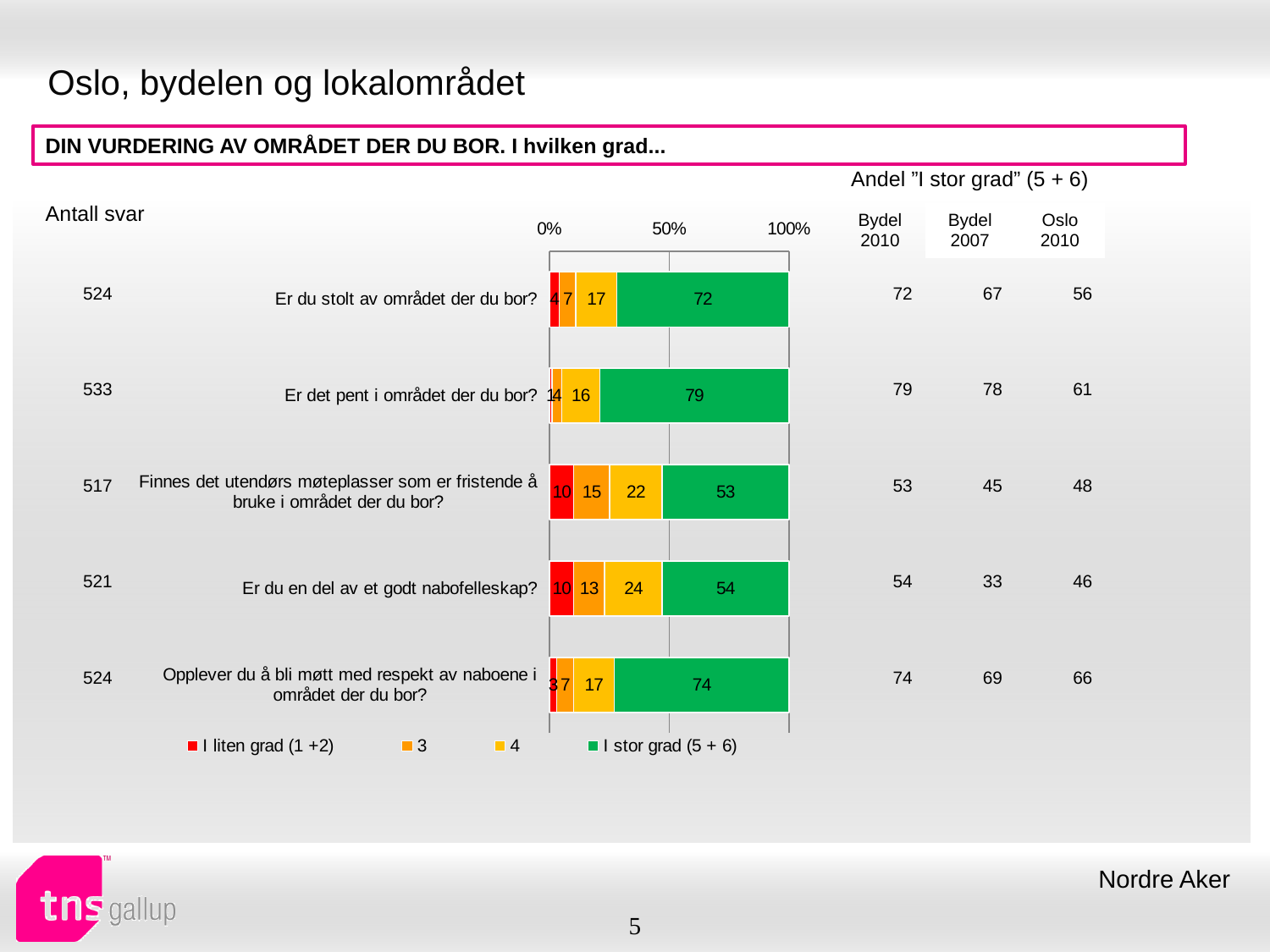
Which question has the lowest 'I stor grad (5 + 6)' value? Finnes det utendørs møteplasser som er fristende å bruke i området der du bor? Which question has the highest 'I stor grad (5 + 6)' value? Er det pent i området der du bor? What type of chart is shown on the slide? stacked bar chart What is the 'I stor grad (5 + 6)' value for 'Er du en del av et godt nabofelleskap?' 54 Which legend entry is shown in green? I stor grad (5 + 6) What is the value of series '4' for 'Finnes det utendørs møteplasser som er fristende å bruke i området der du bor?' 22 What is the difference between the 'I stor grad (5 + 6)' values for 'Er det pent i området der du bor?' and 'Er du stolt av området der du bor?' 7 What is the value of series '3' for 'Er du en del av et godt nabofelleskap?' 13 How many series does the chart legend list? 4 What is the 'I stor grad (5 + 6)' value for 'Er det pent i området der du bor?' 79 Which has a larger 'I stor grad (5 + 6)' value: 'Opplever du å bli møtt med respekt av naboene i området der du bor?' or 'Er du stolt av området der du bor?' Opplever du å bli møtt med respekt av naboene i området der du bor? How many questions (categories) are plotted in the bar chart? 5